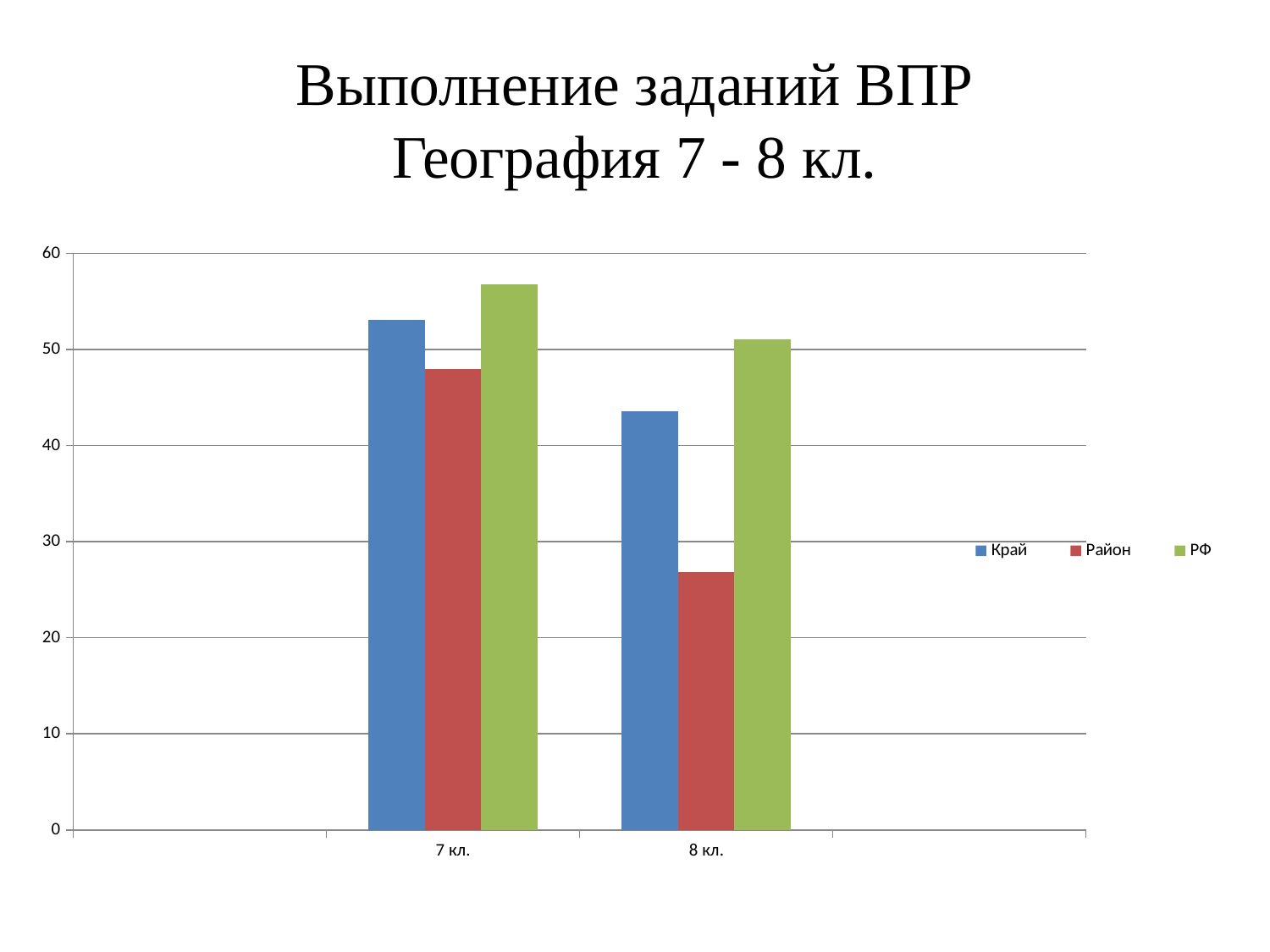
How many series does the legend list? 3 Is the value for Край in 8 кл. greater or less than 40? greater Is the value for РФ in 7 кл. greater or less than 50? greater Is the value for Район in 8 кл. greater or less than 30? less Which series has the highest value for 7 кл.? РФ Which is larger: the value for Район in 7 кл. or the value for РФ in 8 кл.? РФ in 8 кл. Do the values for Район rise or fall from 7 кл. to 8 кл.? fall What is the title of the slide? Выполнение заданий ВПР География 7 - 8 кл. Which is larger: the value for Край in 7 кл. or the value for Край in 8 кл.? Край in 7 кл. What kind of chart is shown on the slide? bar chart Which series has the lowest value for 8 кл.? Район How many categories are shown on the x axis? 2